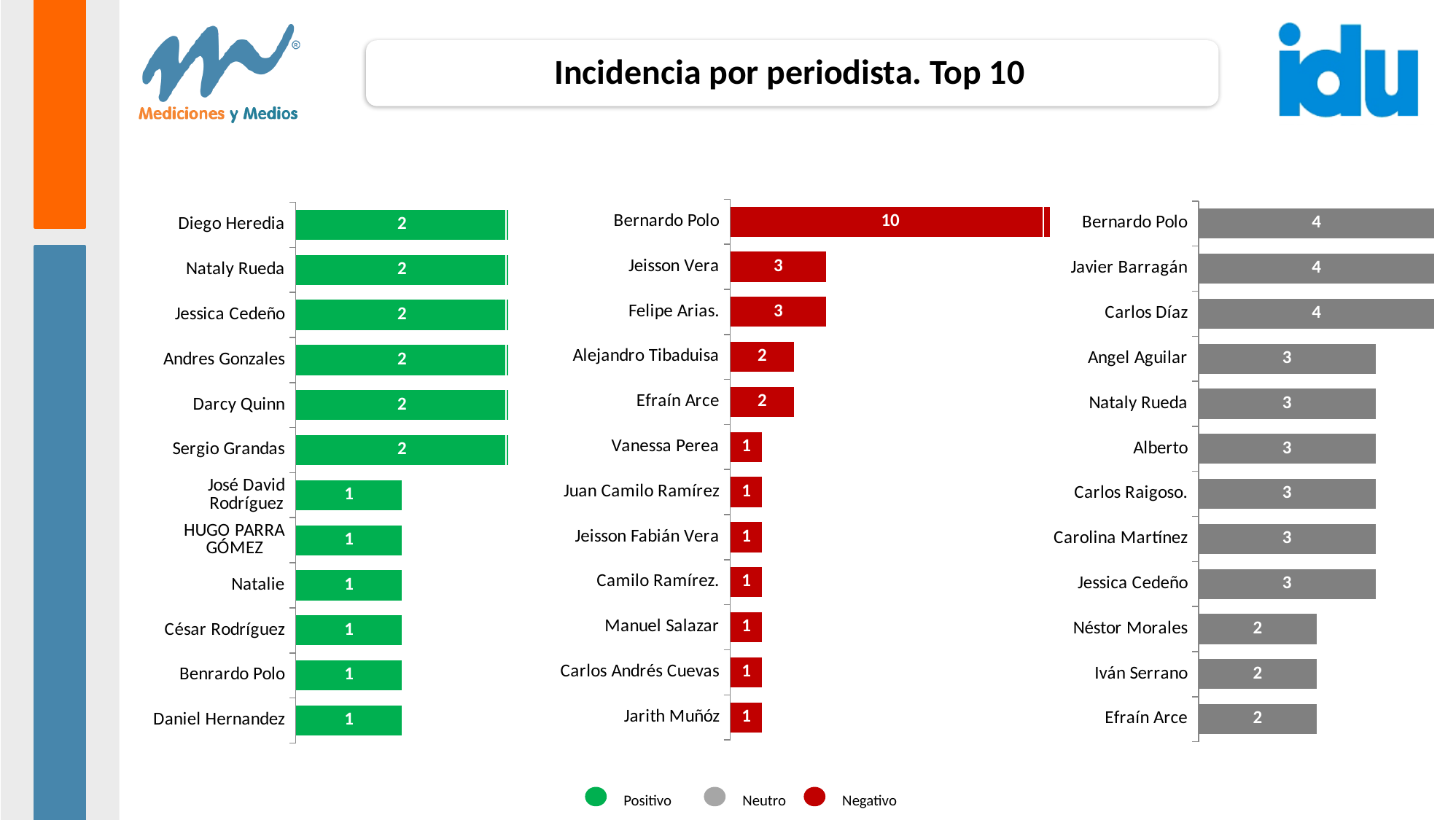
Which legend entry is shown in red? Negativo How many entries does the legend at the bottom of the slide list? 3 In the middle (red, Negativo) chart, what is the difference between Bernardo Polo and Jeisson Vera? 7 In the right (grey, Neutro) chart, what is the difference between Bernardo Polo and Efraín Arce? 2 What is the title of the slide's chart section? Incidencia por periodista. Top 10 In the middle (red, Negativo) chart, what is the value for Bernardo Polo? 10 What type of chart is used for the middle (red, Negativo) chart? Bar chart In the right (grey, Neutro) chart, what is the value for Carolina Martínez? 3 In the middle (red, Negativo) chart, which journalist has the highest value? Bernardo Polo How many journalists are shown in the left (green, Positivo) chart? 12 In the left (green, Positivo) chart, what is the value for Daniel Hernandez? 1 In the right (grey, Neutro) chart, which is larger, the value for Angel Aguilar or the value for Néstor Morales? Angel Aguilar